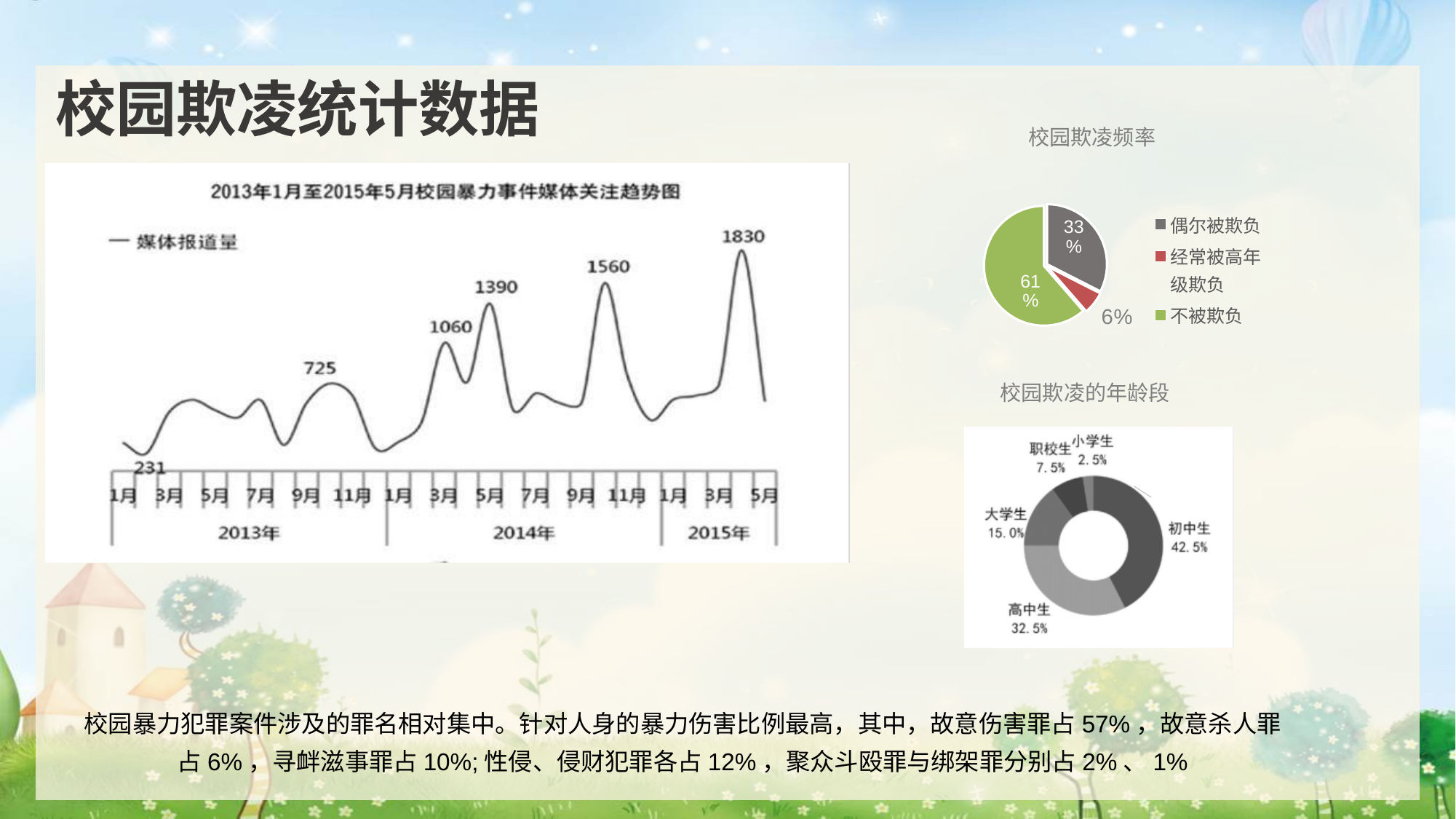
In the chart titled 校园欺凌的年龄段, which category has the largest share? 初中生 In the line chart titled 2013年1月至2015年5月校园暴力事件媒体关注趋势图, what is the labeled peak value in 5月 of 2014年? 1390 In the line chart titled 2013年1月至2015年5月校园暴力事件媒体关注趋势图, what is the difference between the peak labeled 1830 and the peak labeled 1560? 270 In the line chart titled 2013年1月至2015年5月校园暴力事件媒体关注趋势图, do the labeled peak values rise or fall over time? rise In the chart titled 校园欺凌的年龄段, how many categories are shown? 5 In the line chart titled 2013年1月至2015年5月校园暴力事件媒体关注趋势图, what is the lowest labeled value? 231 In the pie chart titled 校园欺凌频率, which category has the smallest share? 经常被高年级欺负 What kind of chart is the chart titled 2013年1月至2015年5月校园暴力事件媒体关注趋势图? line chart In the chart titled 校园欺凌的年龄段, what is the value for 高中生? 32.5% In the pie chart titled 校园欺凌频率, what share is 不被欺负? 61% In the line chart titled 2013年1月至2015年5月校园暴力事件媒体关注趋势图, what is the highest labeled value? 1830 In the pie chart titled 校园欺凌频率, how many categories does the legend list? 3